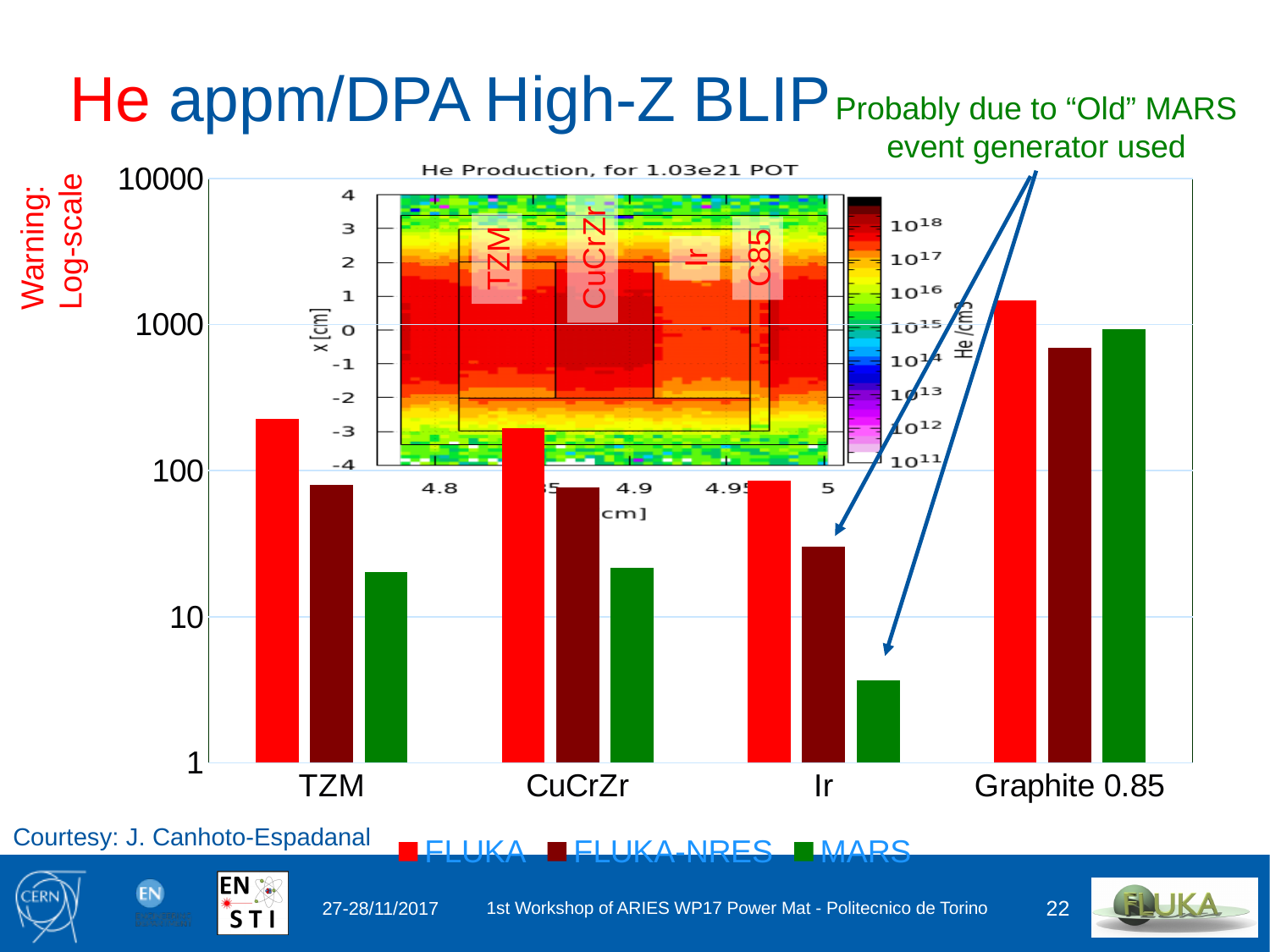
Is the MARS value for TZM greater or less than 100? less Which series are listed in the legend of the bar chart? FLUKA, FLUKA-NRES, MARS How many series does the legend of the bar chart list? 3 Which category has the lowest MARS value in the bar chart? Ir Is the FLUKA value for Graphite 0.85 greater or less than 1000? greater For TZM, which is larger: the FLUKA value or the MARS value? FLUKA What scale does the y axis of the bar chart use, according to the warning on the slide? Log-scale Is the MARS value for Ir greater or less than 10? less Which category has the highest FLUKA value in the bar chart? Graphite 0.85 How many categories are shown on the x axis of the bar chart? 4 What kind of chart is shown on the slide? bar chart